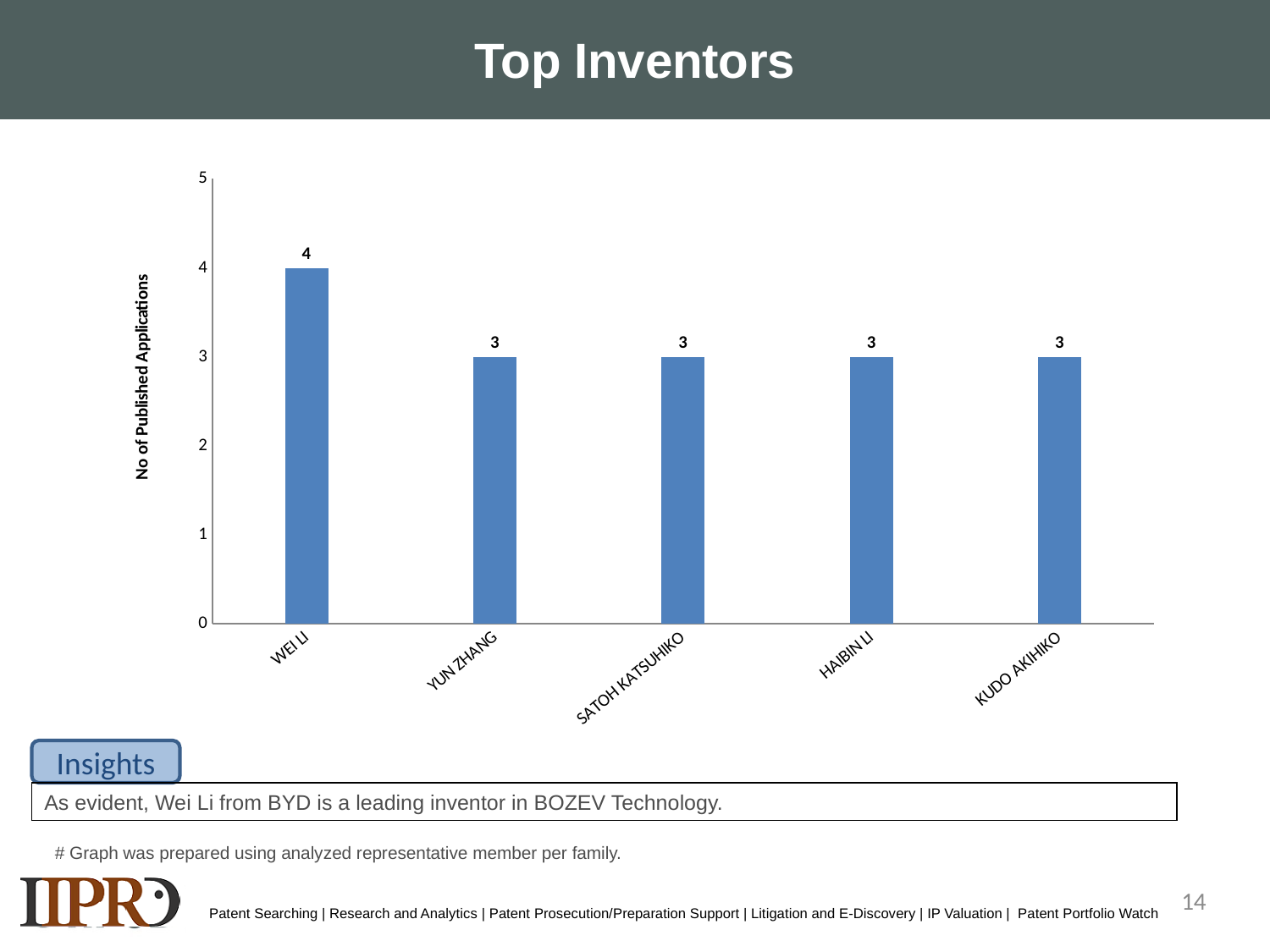
How many inventors are shown in the chart? 5 Who has more published applications, WEI LI or YUN ZHANG? WEI LI Which inventor has the highest number of published applications? WEI LI What is the title of the slide containing the chart? Top Inventors What is the label of the vertical axis of the chart? No of Published Applications How many published applications does SATOH KATSUHIKO have? 3 How many published applications does YUN ZHANG have? 3 What is the difference between the number of published applications for WEI LI and HAIBIN LI? 1 How many published applications does WEI LI have? 4 Is the value for HAIBIN LI greater or less than 4? less How many published applications does KUDO AKIHIKO have? 3 What kind of chart is shown on the slide? Bar chart